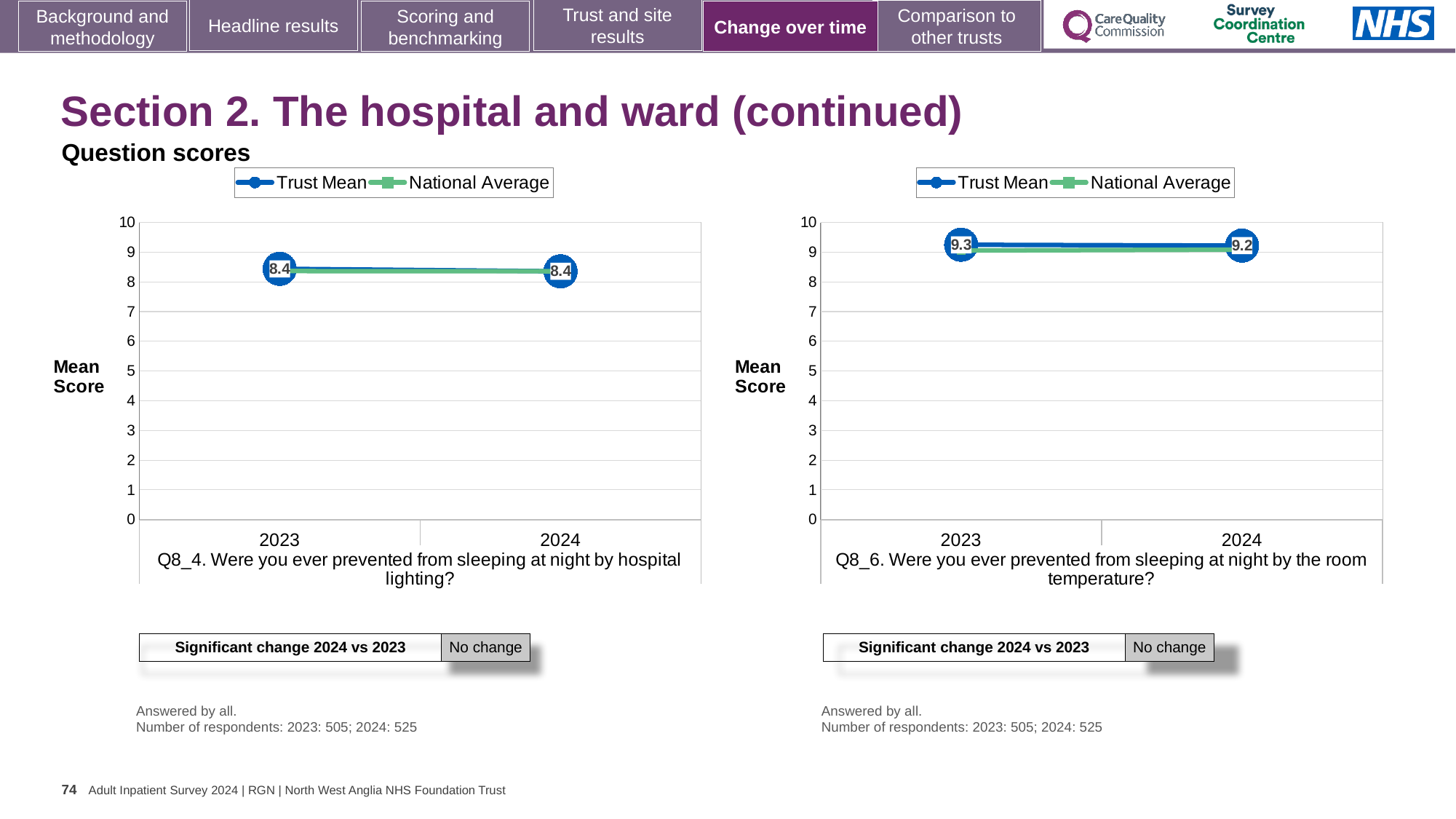
How many series does the legend of the left chart (Q8_4, hospital lighting) list? 2 On the left chart (Q8_4, hospital lighting), what is the Trust Mean score for 2024? 8.4 How many years are plotted on the x axis of the right chart (Q8_6, room temperature)? 2 On the left chart (Q8_4, hospital lighting), what is the difference between the Trust Mean scores for 2023 and 2024? 0 On the left chart (Q8_4, hospital lighting), what is the Trust Mean score for 2023? 8.4 On the right chart (Q8_6, room temperature), what is the Trust Mean score for 2023? 9.3 On the right chart (Q8_6, room temperature), what is the Trust Mean score for 2024? 9.2 On the left chart (Q8_4, hospital lighting), is the National Average value for 2024 greater or less than 8? greater On the right chart (Q8_6, room temperature), does the Trust Mean rise, fall or stay the same from 2023 to 2024? fall On the right chart (Q8_6, room temperature), what is the difference between the Trust Mean scores for 2023 and 2024? 0.1 What kind of chart is the left chart (Q8_4, hospital lighting)? line chart On the right chart (Q8_6, room temperature), is the National Average value for 2023 greater or less than 8? greater